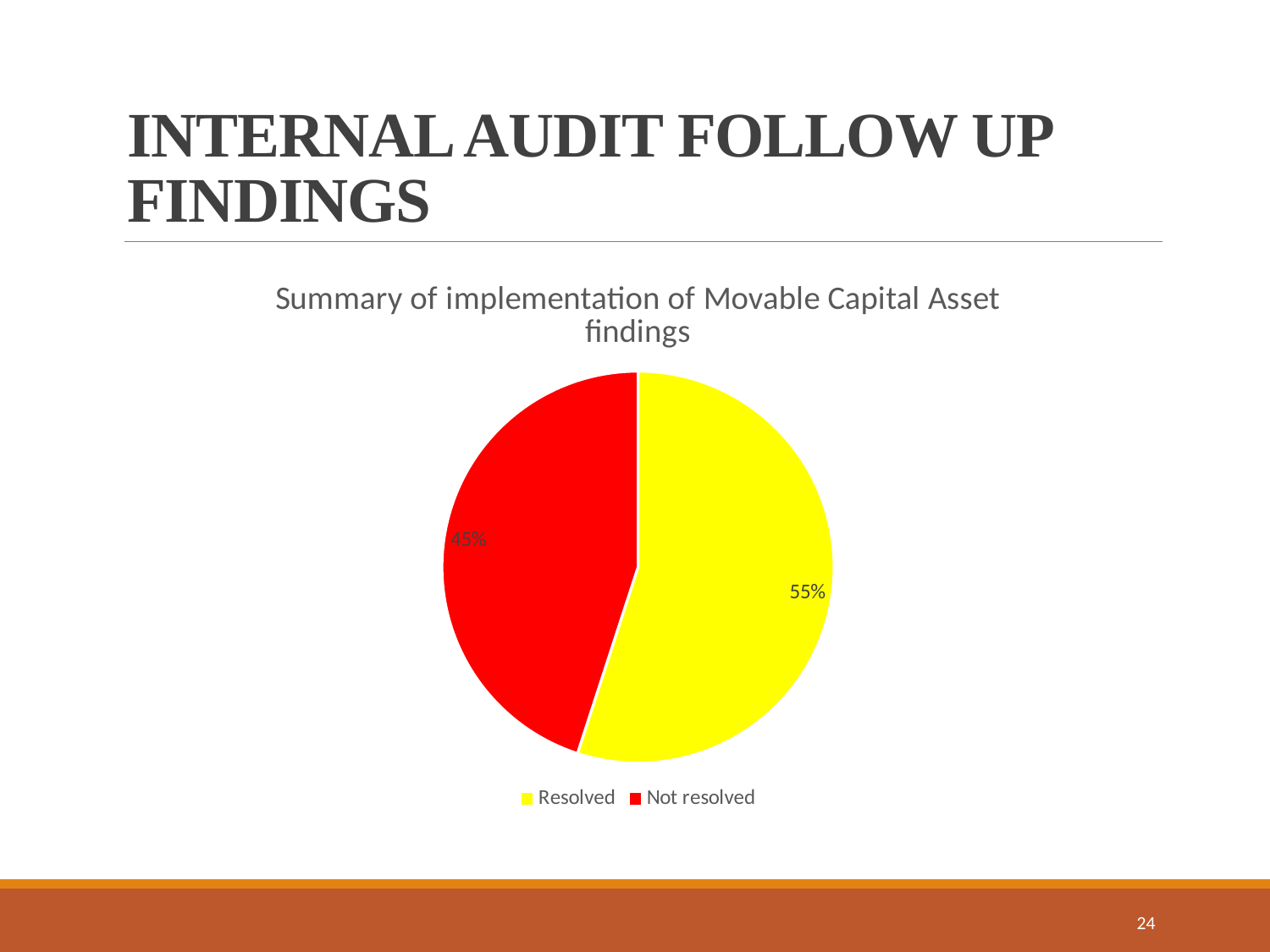
Which category has the smaller share of the pie? Not resolved What is the title of the chart? Summary of implementation of Movable Capital Asset findings What colour represents the Not resolved slice? red Is the share for Not resolved greater or less than 50%? less Is the share for Resolved larger or smaller than the share for Not resolved? larger What percentage of findings are Not resolved? 45% What type of chart is shown on the slide? pie chart Which category has the larger share of the pie? Resolved What percentage of findings are Resolved? 55% What is the difference in percentage points between Resolved and Not resolved? 10 How many entries does the legend list? 2 How many categories does the pie chart show? 2